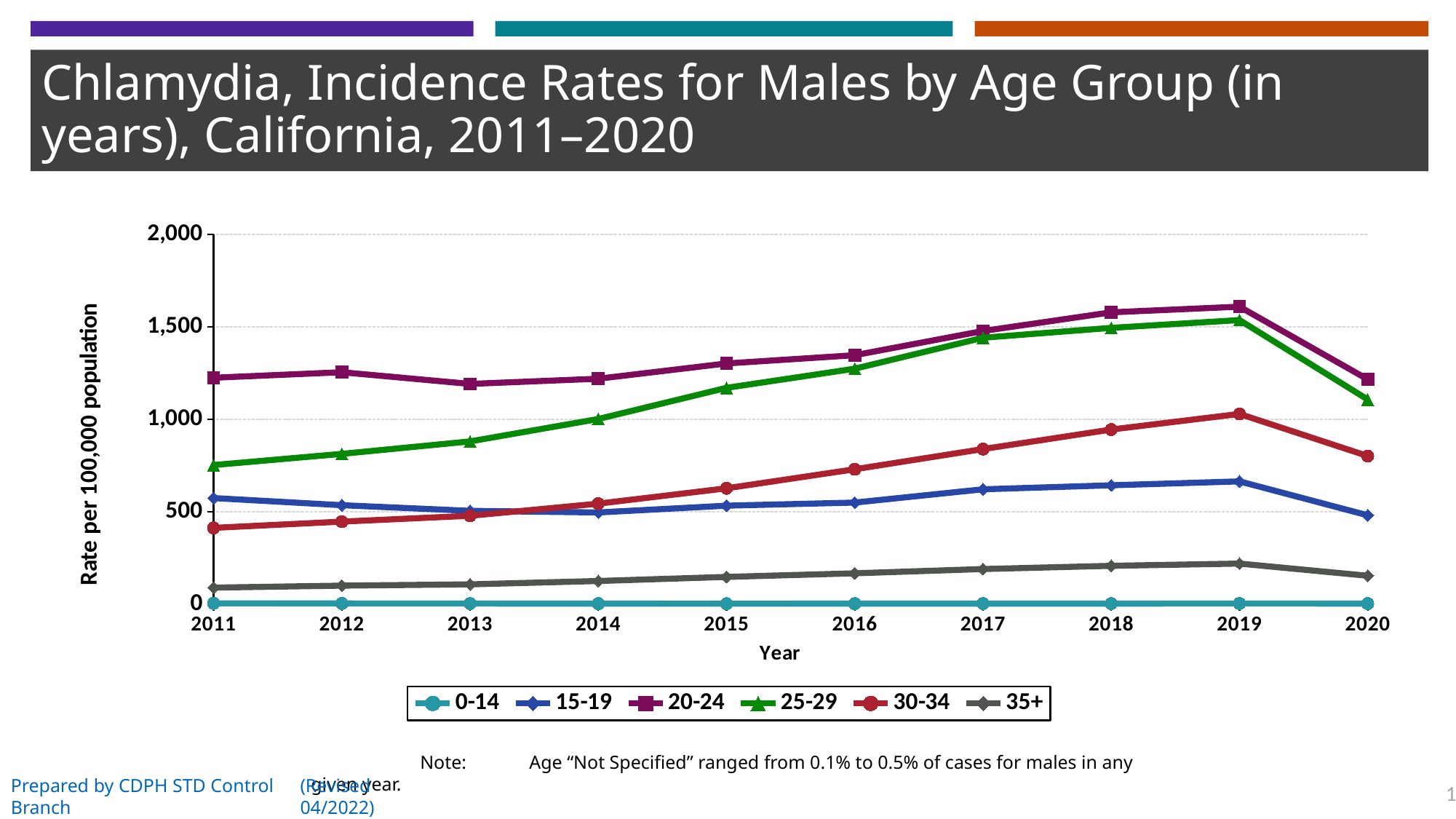
Is the value for the 35+ age group in 2019 greater or less than 500? less How many years are plotted along the x axis? 10 Which age group has the highest incidence rate in 2019? 20-24 What kind of chart is shown on the slide? line chart Which age group has the lowest incidence rate across all years? 0-14 In which year does the 20-24 age group reach its highest rate? 2019 Is the value for the 20-24 age group in 2019 greater or less than 1,500? greater How many age groups does the legend list? 6 Is the value for the 25-29 age group in 2011 greater or less than 1,000? less Does the rate for the 25-29 age group rise or fall from 2011 to 2019? rise What is the label of the y axis? Rate per 100,000 population In 2019, which has the higher rate: the 25-29 age group or the 30-34 age group? 25-29